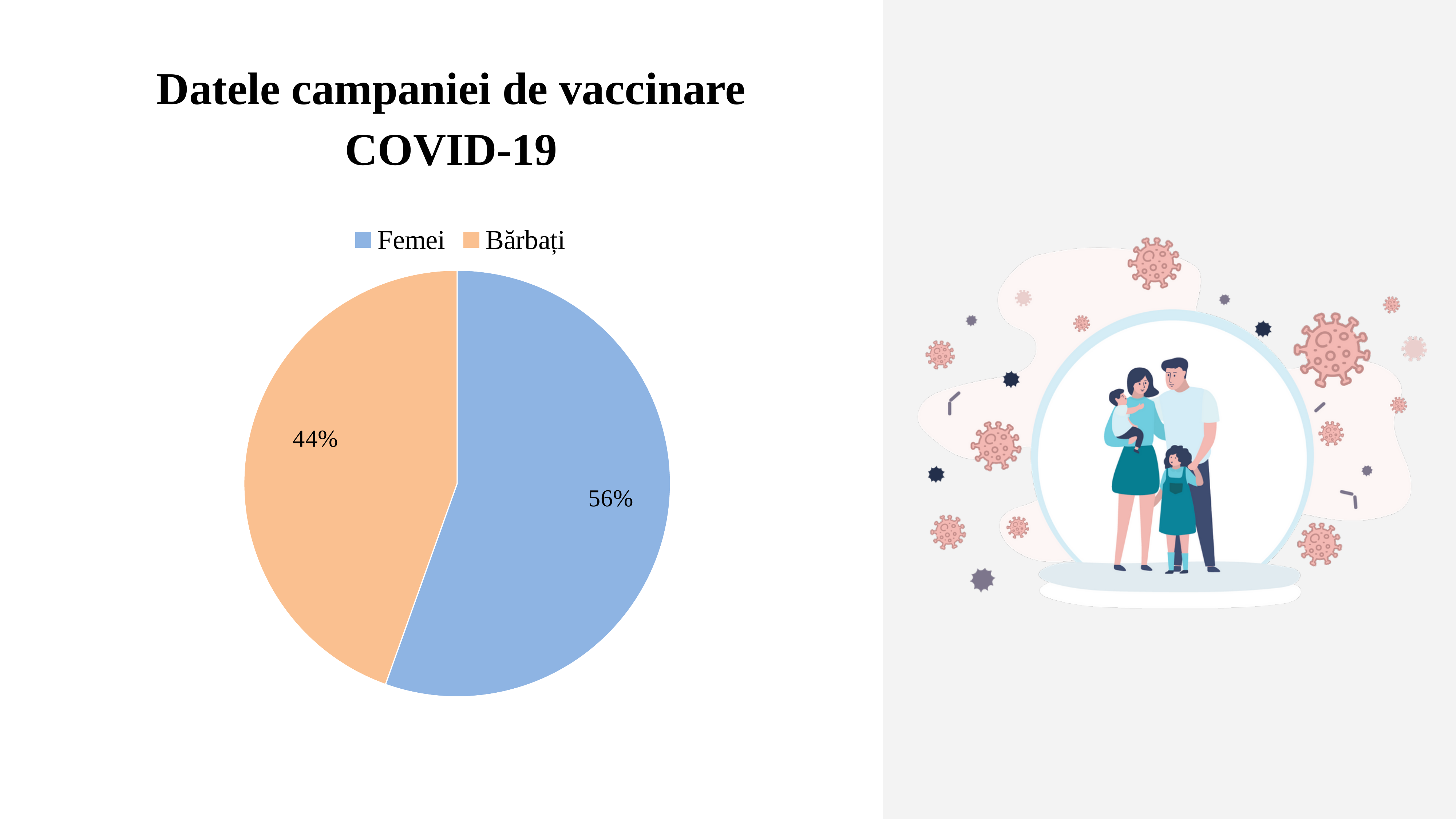
How many slices does the pie chart have? 2 Which category has the largest slice of the pie? Femei Which slice is larger, Femei or Bărbați? Femei What is the difference in percentage points between the Femei and Bărbați slices? 12 What share of the pie does Femei represent? 56% What kind of chart is shown on the slide? Pie chart What is the title shown above the chart? Datele campaniei de vaccinare COVID-19 How many entries does the legend list? 2 Which category has the smallest slice of the pie? Bărbați What colour is the Bărbați slice? Orange What share of the pie does Bărbați represent? 44%